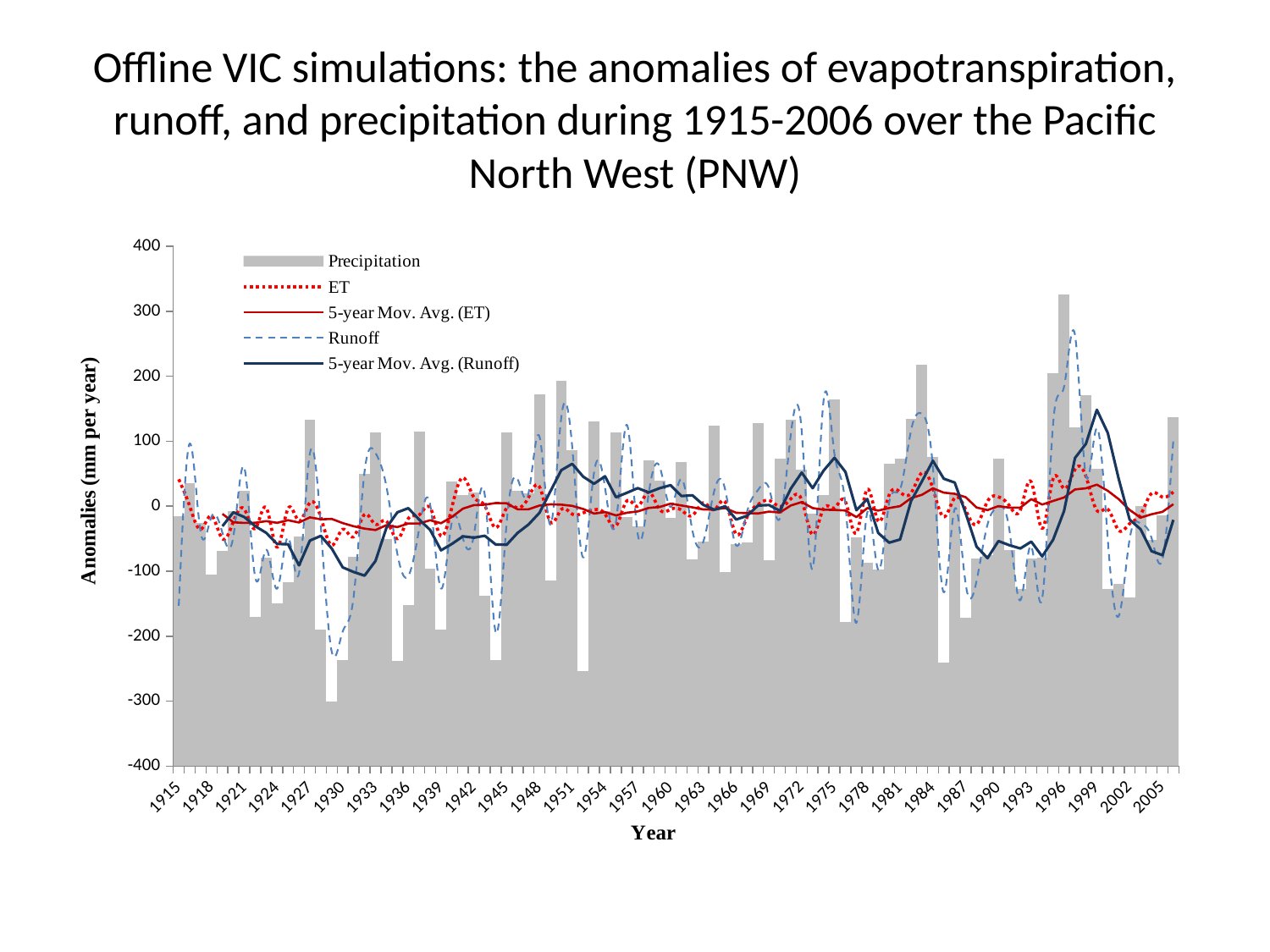
Is the precipitation anomaly for 1996 greater or less than 300? greater Is the 5-year Mov. Avg. (ET) value for 1960 greater or less than 100? less In which year is the precipitation anomaly lowest? 1929 Is the precipitation anomaly for 1929 greater or less than -200? less How many of the legend series are plotted as lines rather than bars? 4 What is the label on the vertical axis? Anomalies (mm per year) Which series is drawn as grey bars? Precipitation How many series does the legend list? 5 What kind of chart is shown on the slide? A combination bar and line chart In which year is the precipitation anomaly highest? 1996 Which year has the larger precipitation anomaly, 1996 or 1984? 1996